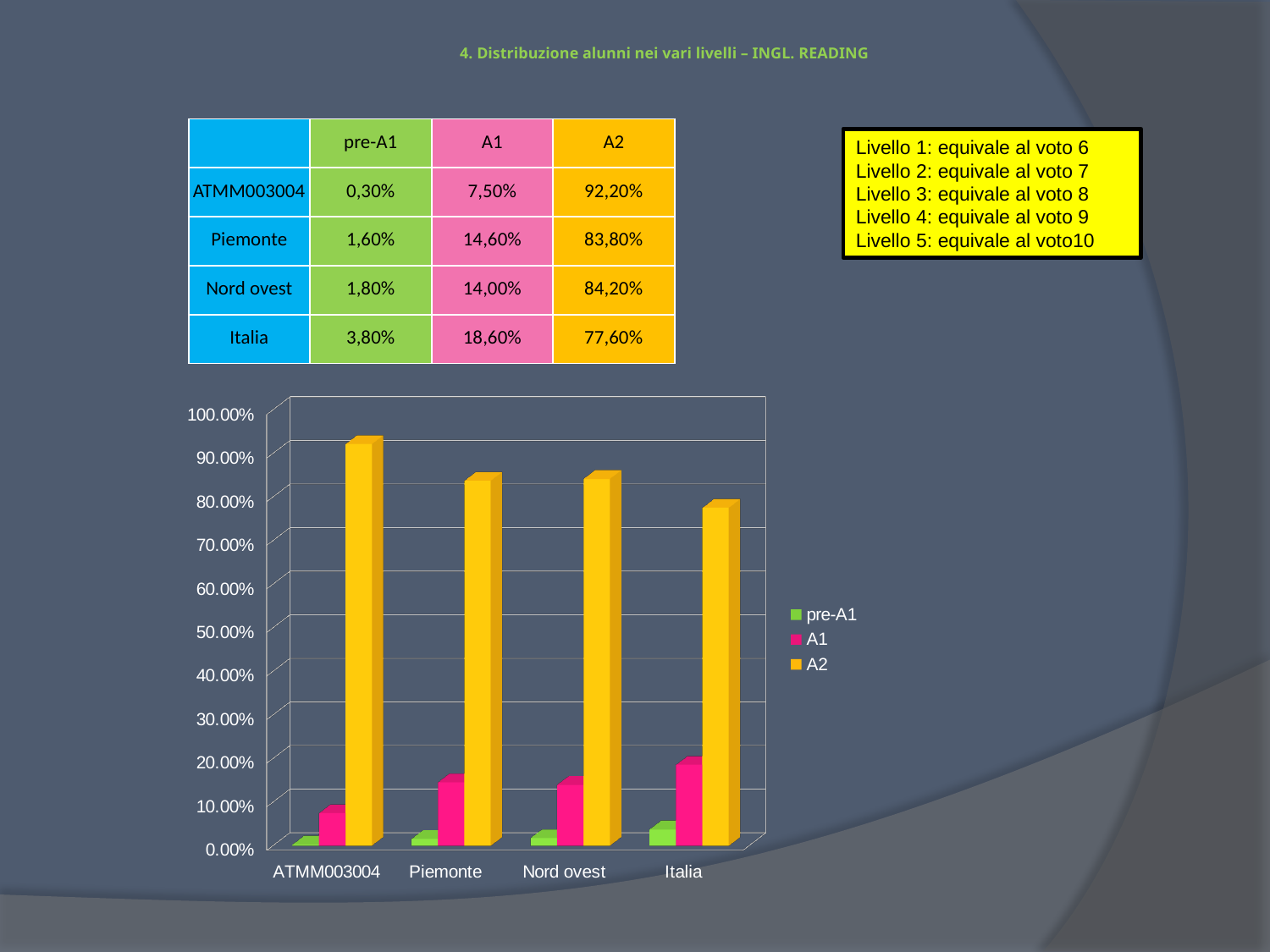
Which colour represents the A2 series in the chart? yellow Which category has the lowest pre-A1 value? ATMM003004 How many series does the chart legend list? 3 What is the difference between the A2 value for ATMM003004 and the A2 value for Italia? 14,60% What is the A2 value for ATMM003004? 92,20% Which category has the highest A2 value? ATMM003004 Is the A2 value for Italia greater or less than 80.00%? less What is the pre-A1 value for Piemonte? 1,60% What kind of chart is shown on the slide? bar chart What is the A1 value for Italia? 18,60% Which is larger, the A1 value for Piemonte or the A1 value for Italia? Italia How many categories are shown on the x axis of the chart? 4